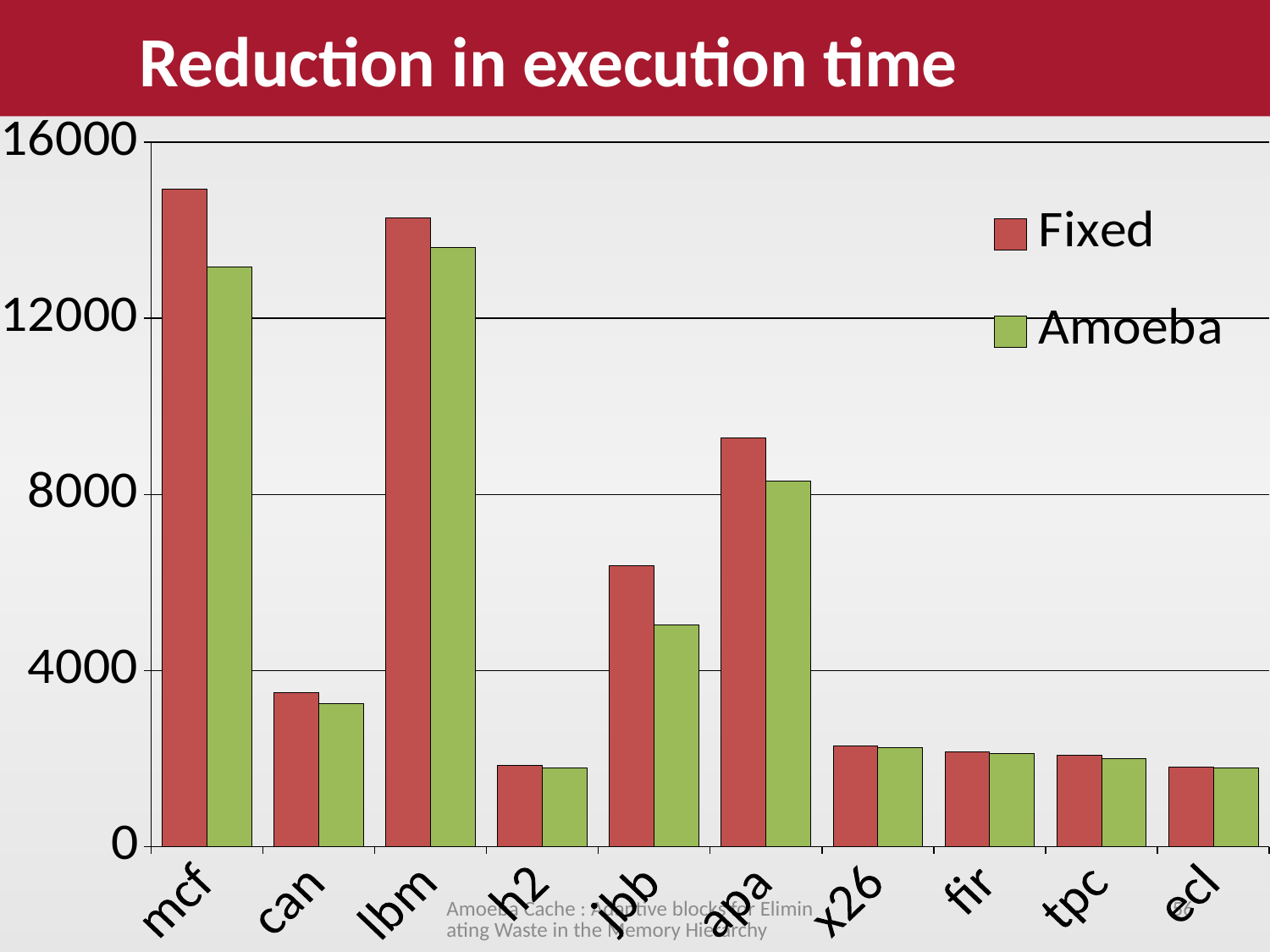
Is the Fixed value for mcf greater or less than 12000? greater How many categories are shown along the x axis? 10 Which is larger: the Fixed value for apa or the Fixed value for lbm? lbm Which category has the highest Amoeba value? lbm What colour represents the Amoeba series in the legend? green How many series does the legend list? 2 Is the Amoeba value for apa greater or less than 8000? greater Is the Fixed value for can greater or less than 4000? less Which category has the highest Fixed value? mcf For jbb, which is larger: the Fixed value or the Amoeba value? Fixed What kind of chart is shown on the slide? bar chart